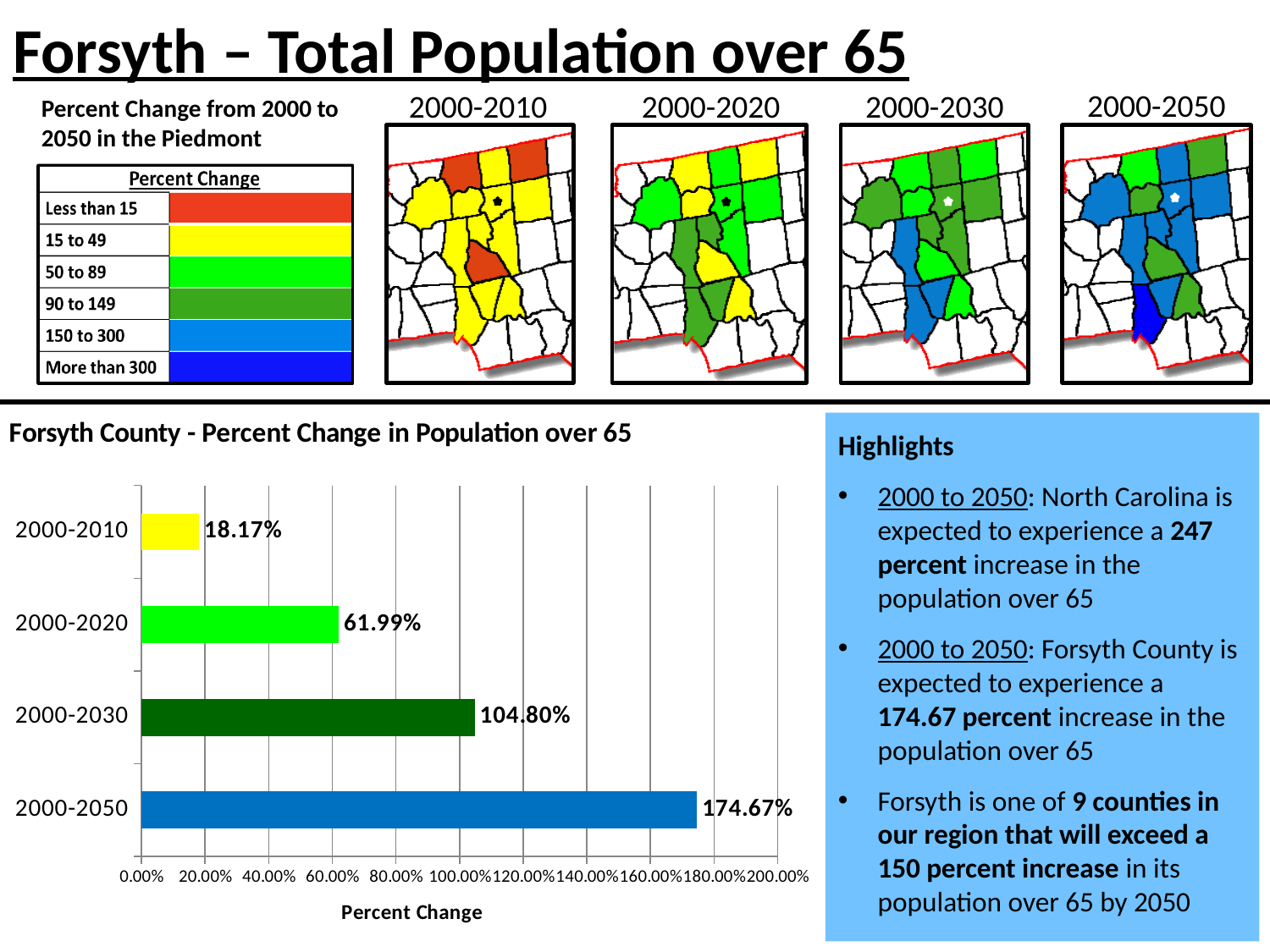
Which is larger in the Forsyth County bar chart: the percent change for 2000-2020 or 2000-2030? 2000-2030 What is the percent change for 2000-2020 in the Forsyth County bar chart? 61.99% What is the percent change for 2000-2050 in the Forsyth County bar chart? 174.67% Is the value for 2000-2030 in the Forsyth County bar chart greater or less than 100.00%? greater Which period has the lowest percent change in the Forsyth County bar chart? 2000-2010 Which period has the highest percent change in the Forsyth County bar chart? 2000-2050 What kind of chart is the Forsyth County - Percent Change in Population over 65 chart? bar chart How many periods are shown in the Forsyth County bar chart? 4 What is the difference between the percent change for 2000-2050 and 2000-2030 in the Forsyth County bar chart? 69.87% What is the percent change for 2000-2030 in the Forsyth County bar chart? 104.80% What is the x-axis label of the Forsyth County bar chart? Percent Change What is the percent change for 2000-2010 in the Forsyth County bar chart? 18.17%